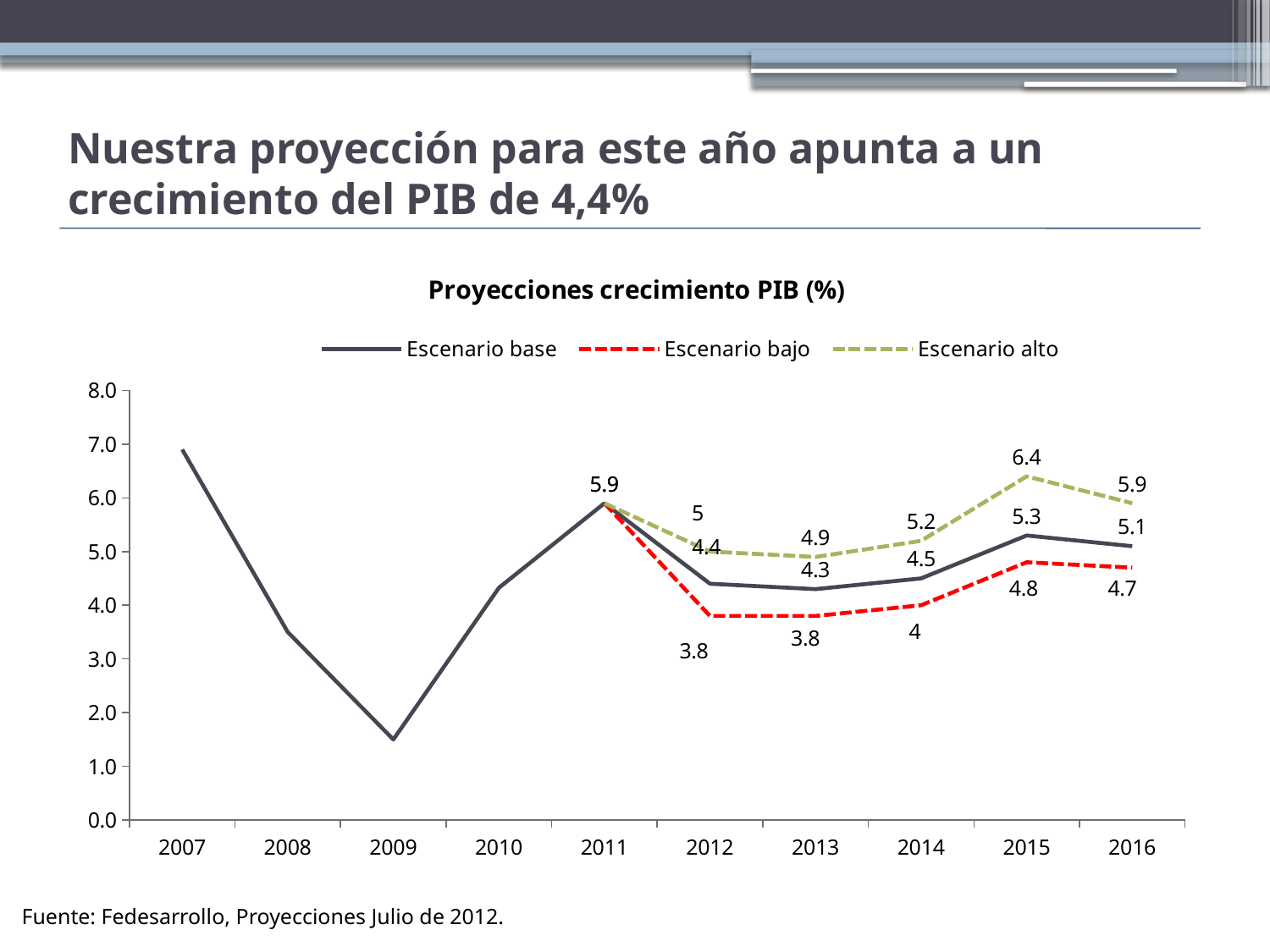
What is the value of Escenario alto in 2015? 6.4 What is the value of Escenario bajo in 2014? 4 In which year is the Escenario base line at its lowest point? 2009 What is the difference between Escenario alto and Escenario bajo in 2015? 1.6 In which year does the Escenario alto series reach its highest value? 2015 Which is larger for Escenario base: the value in 2014 or the value in 2016? 2016 What kind of chart is shown on the slide? line chart What is the value of Escenario base in 2012? 4.4 Does the Escenario bajo series rise or fall from 2013 to 2015? rise Is the value for 2009 greater or less than 2.0? less How many series does the legend list? 3 Is the value for 2007 greater or less than 6.0? greater